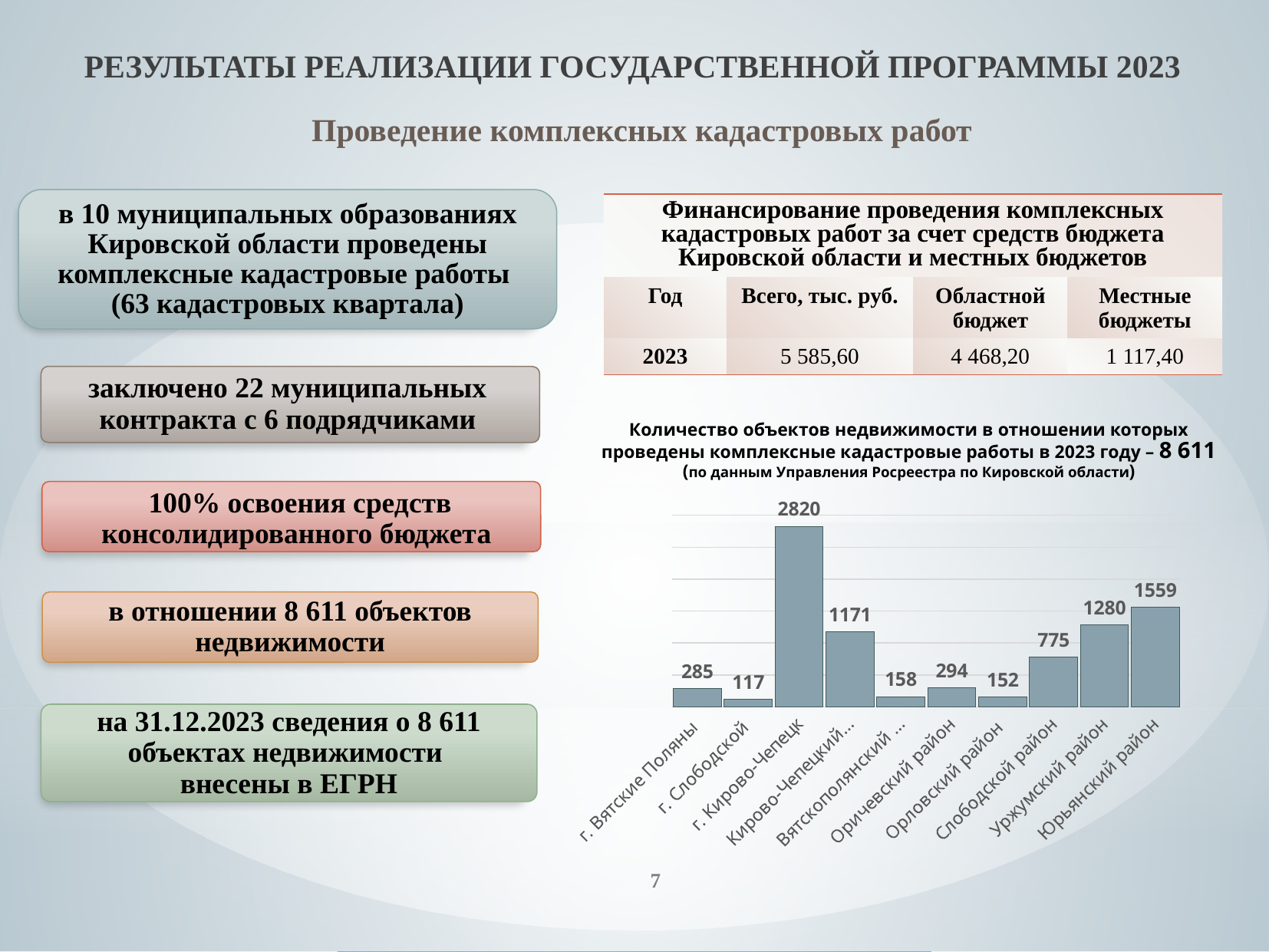
How many categories are shown in the bar chart? 10 What is the difference between the values for г. Кирово-Чепецк and Слободской район? 2045 Which category has the highest value in the bar chart? г. Кирово-Чепецк What is the value for г. Слободской in the bar chart? 117 What is the value for г. Кирово-Чепецк in the bar chart? 2820 What is the value for Уржумский район in the bar chart? 1280 Which is larger in the bar chart: Оричевский район or г. Вятские Поляны? Оричевский район What is the value for Орловский район in the bar chart? 152 What is the difference between the values for Юрьянский район and Уржумский район? 279 According to the chart title, what is the total number of real estate objects for which complex cadastral works were carried out in 2023? 8 611 Which category has the lowest value in the bar chart? г. Слободской What type of chart is shown on the slide? bar chart